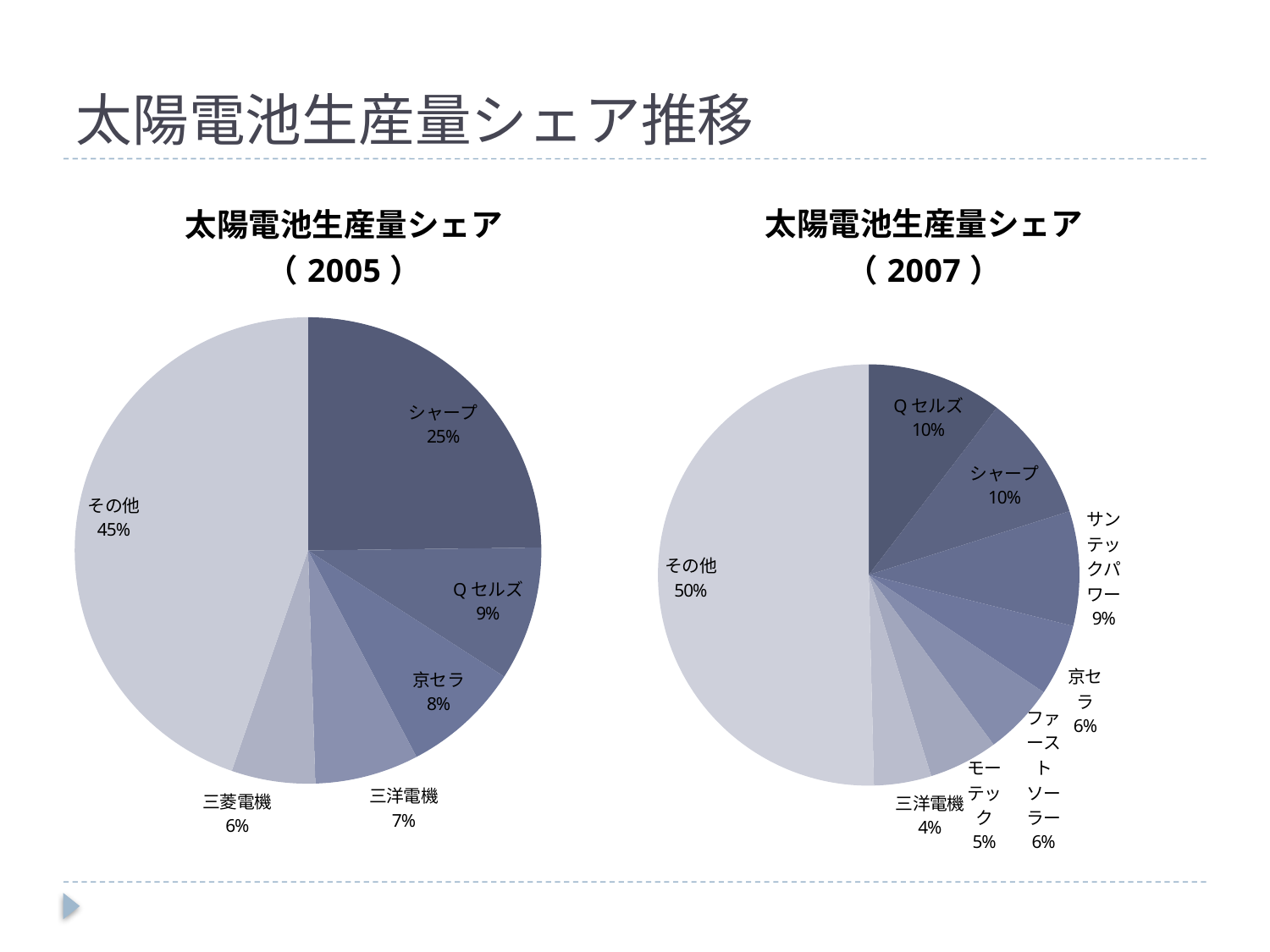
In the 太陽電池生産量シェア（2005） chart, what is the difference between the shares of シャープ and Qセルズ? 16% In the 太陽電池生産量シェア（2007） chart, what share does サンテックパワー have? 9% What type of chart is used on this slide? Pie chart In the 太陽電池生産量シェア（2007） chart, which slice has the smallest share? 三洋電機 In the 太陽電池生産量シェア（2005） chart, what share does 三洋電機 have? 7% In the 太陽電池生産量シェア（2005） chart, which named company (excluding その他) has the largest share? シャープ In the 太陽電池生産量シェア（2005） chart, what share does シャープ have? 25% In the 太陽電池生産量シェア（2007） chart, what share does その他 have? 50% Which is larger: the share of 京セラ in the 2005 chart or in the 2007 chart? 2005 In the 太陽電池生産量シェア（2005） chart, how many slices does the pie have? 6 In the 太陽電池生産量シェア（2007） chart, how many slices does the pie have? 8 What is the title of the chart on the right side of the slide? 太陽電池生産量シェア（2007）